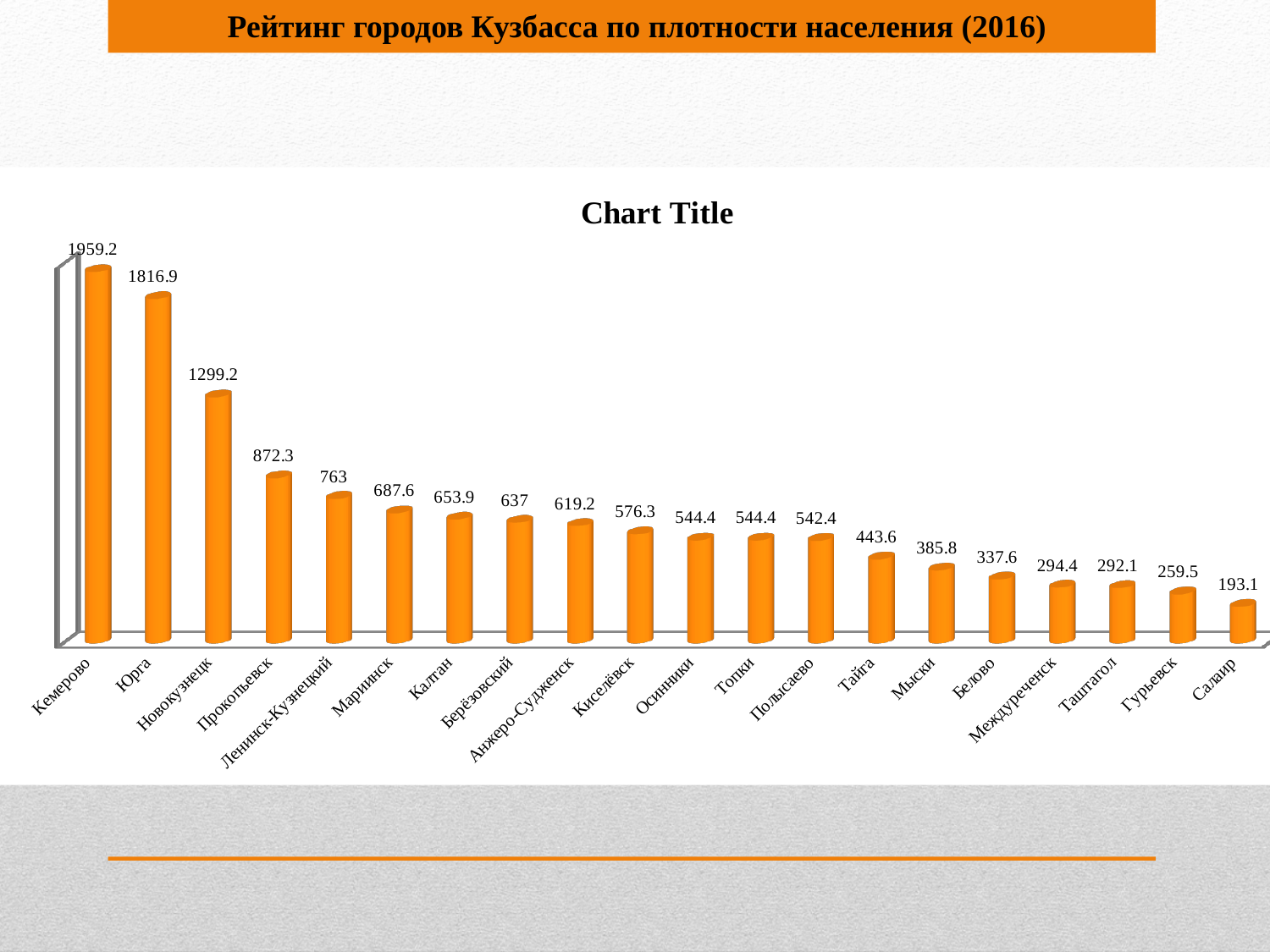
What is the difference between the values for Прокопьевск and Ленинск-Кузнецкий? 109.3 Do the values rise or fall from left to right along the x axis? Fall What kind of chart is shown on the slide? Bar chart What is the value for Новокузнецк? 1299.2 What is the value for Междуреченск? 294.4 Which is larger, the value for Мыски or the value for Белово? Мыски How many cities are shown on the chart? 20 What is the difference between the values for Кемерово and Юрга? 142.3 What is the value for Кемерово? 1959.2 Which city has the highest value? Кемерово What is the value for Тайга? 443.6 Which city has the lowest value? Салаир